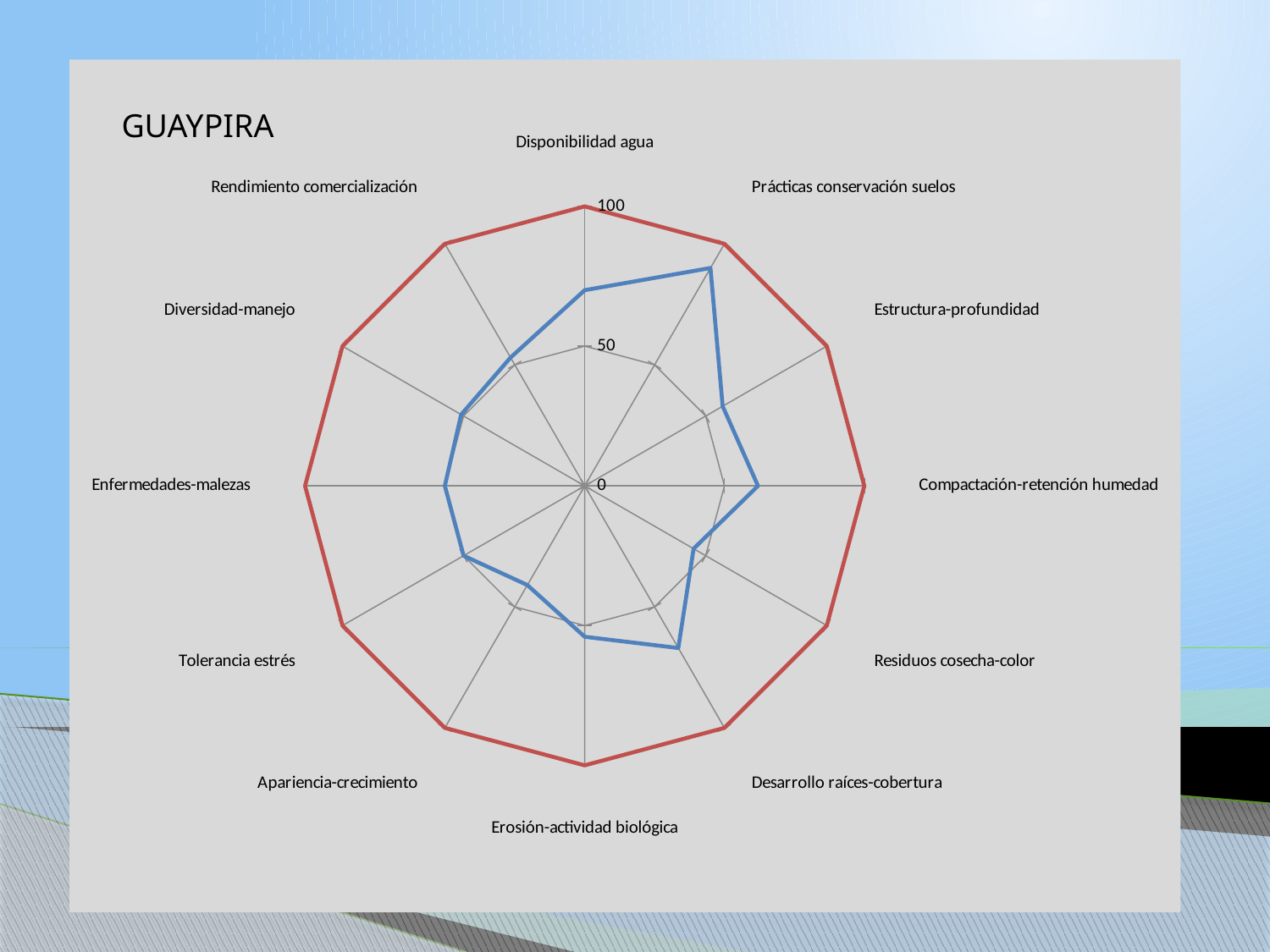
What value does the red series reach for Enfermedades-malezas? 100 Is the blue series value for Prácticas conservación suelos greater or less than 50? greater In the blue series, which is larger: Disponibilidad agua or Enfermedades-malezas? Disponibilidad agua How many categories (axes) does the radar chart have? 12 Is the blue series value for Desarrollo raíces-cobertura greater or less than 50? greater In the blue series, which is larger: Prácticas conservación suelos or Estructura-profundidad? Prácticas conservación suelos For which category does the blue series reach its highest value? Prácticas conservación suelos Is the blue series value for Disponibilidad agua greater or less than 50? greater What kind of chart is shown on the slide? radar chart How many data series are plotted on the radar chart? 2 What is the title shown above the chart? GUAYPIRA What value does the red series reach for Disponibilidad agua? 100